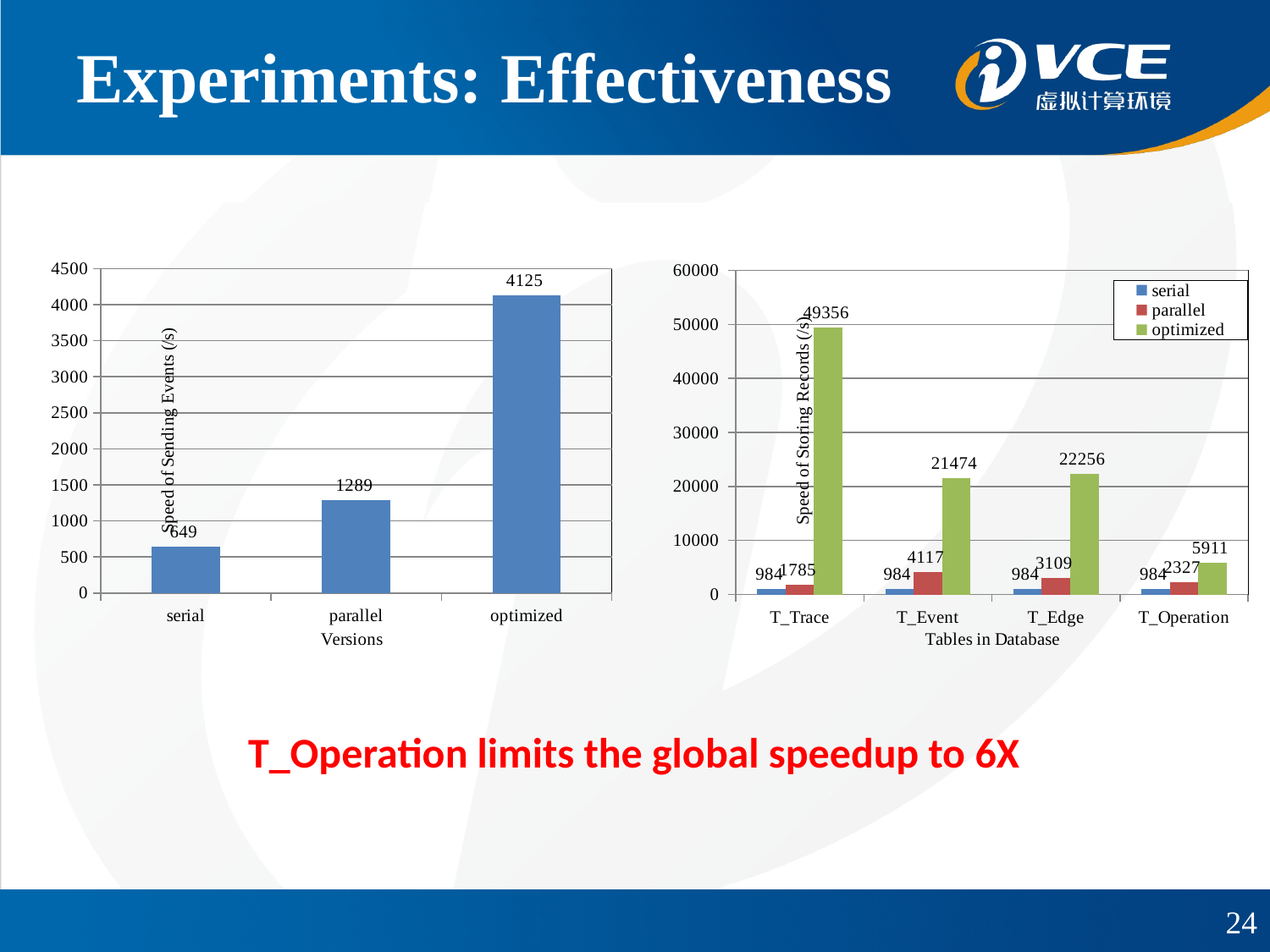
In the right chart (Speed of Storing Records), which table has the lowest optimized value? T_Operation In the left chart (Speed of Sending Events), what is the value for the serial version? 649 In the right chart (Speed of Storing Records), what is the optimized value for T_Trace? 49356 In the left chart (Speed of Sending Events), what is the difference between the optimized and parallel values? 2836 In the left chart (Speed of Sending Events), what is the value for the optimized version? 4125 In the right chart (Speed of Storing Records), what is the difference between the optimized and serial values for T_Operation? 4927 In the left chart (Speed of Sending Events), which version has the lowest speed? serial What kind of chart is the right chart (Speed of Storing Records)? bar chart In the right chart (Speed of Storing Records), is the optimized value for T_Edge larger than the optimized value for T_Event? Yes In the left chart (Speed of Sending Events), how many versions are shown on the x axis? 3 In the right chart (Speed of Storing Records), how many series does the legend list? 3 In the right chart (Speed of Storing Records), what is the parallel value for T_Event? 4117